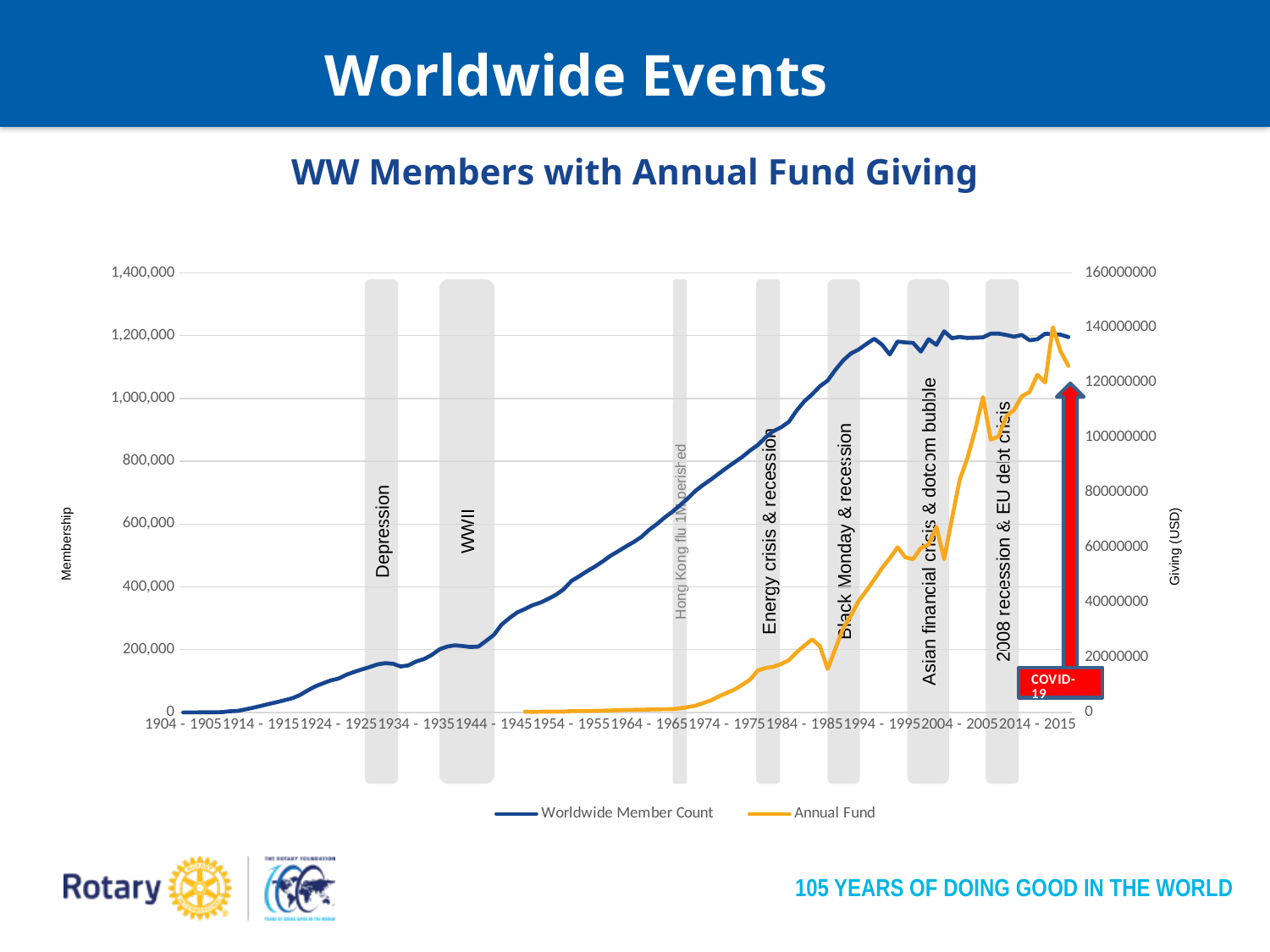
Is the Worldwide Member Count for 1934 - 1935 greater or less than 200,000? less Is the Worldwide Member Count for 1964 - 1965 greater or less than 400,000? greater How many series does the legend list? 2 Is the Annual Fund value for 1954 - 1955 greater or less than 20000000? less What kind of chart is shown on the slide? line chart What is the title of the chart? WW Members with Annual Fund Giving Does the Worldwide Member Count generally rise or fall from 1904 - 1905 to 2014 - 2015? rise What are the two series named in the legend? Worldwide Member Count and Annual Fund Does the Annual Fund generally rise or fall from 1954 - 1955 to 2014 - 2015? rise How many period labels are shown along the x axis? 12